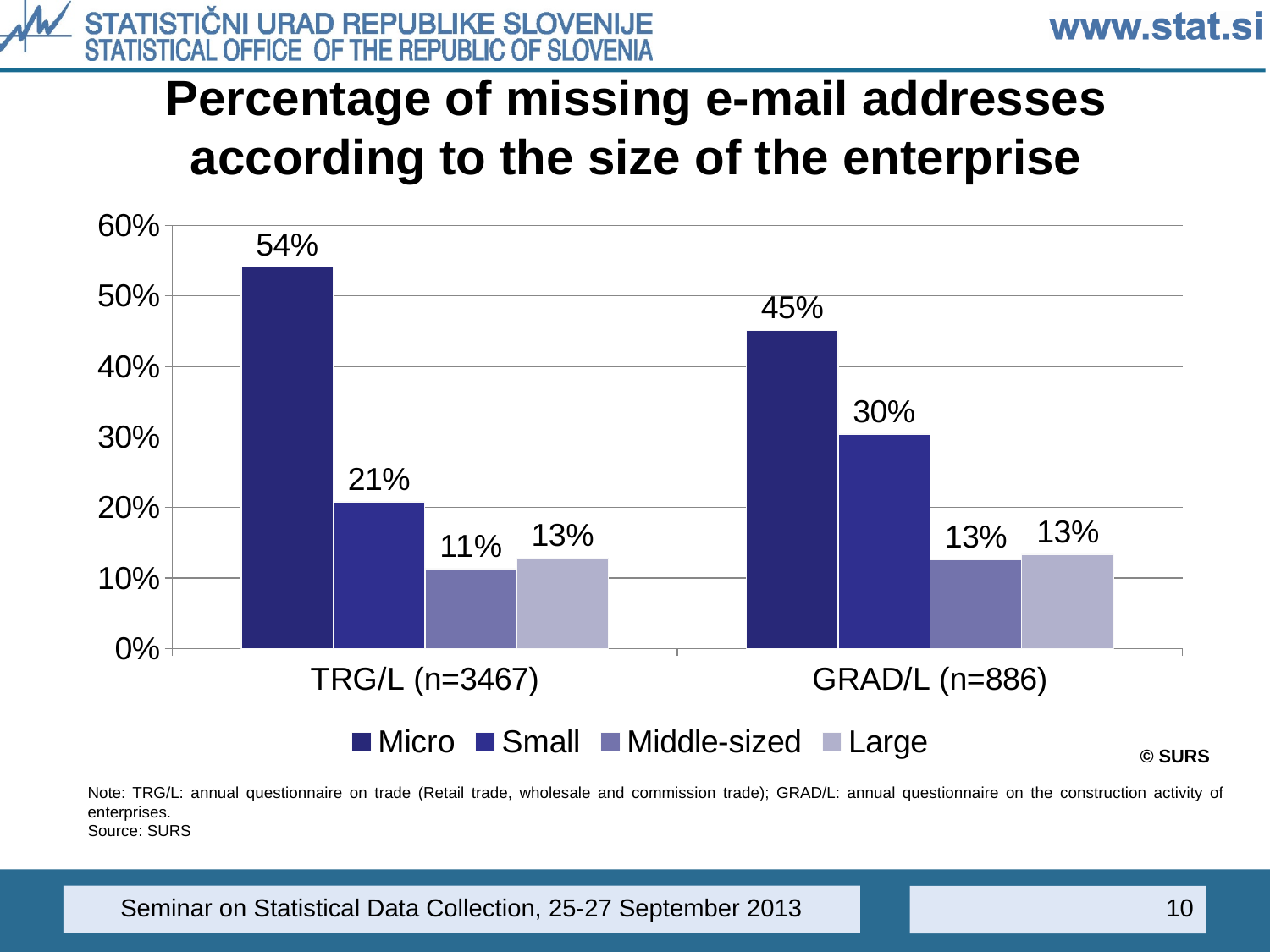
How many questionnaire categories are shown on the x axis? 2 Which enterprise size has the highest percentage of missing e-mail addresses in GRAD/L (n=886)? Micro How many series does the legend list? 4 What kind of chart is shown on the slide? Bar chart Which enterprise size has the lowest percentage of missing e-mail addresses in TRG/L (n=3467)? Middle-sized What is the title of the chart? Percentage of missing e-mail addresses according to the size of the enterprise What is the percentage of missing e-mail addresses for Small enterprises in GRAD/L (n=886)? 30% What is the difference between the Micro values for TRG/L (n=3467) and GRAD/L (n=886)? 9% What is the difference between the Micro and Small values in TRG/L (n=3467)? 33% What is the percentage of missing e-mail addresses for Micro enterprises in TRG/L (n=3467)? 54% Which is larger: the Small value in TRG/L (n=3467) or the Small value in GRAD/L (n=886)? GRAD/L (n=886) What is the value for Middle-sized enterprises in TRG/L (n=3467)? 11%